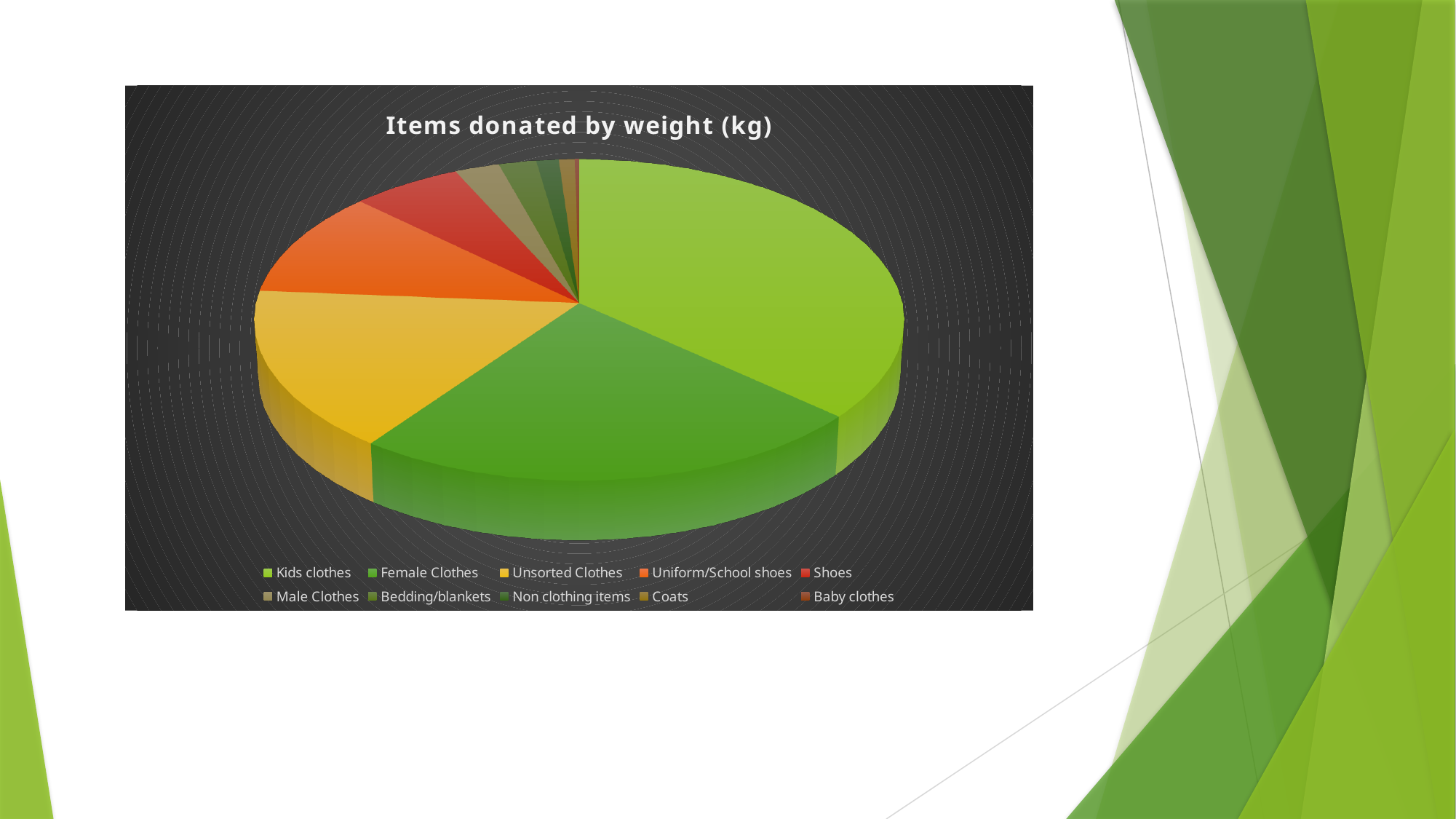
Which slice is larger, Female Clothes or Uniform/School shoes? Female Clothes Which slice is larger, Kids clothes or Unsorted Clothes? Kids clothes What kind of chart is shown on the slide? pie chart How many categories does the pie chart's legend list? 10 What colour is the Unsorted Clothes slice? yellow Which slice is larger, Uniform/School shoes or Baby clothes? Uniform/School shoes What is the title of the chart? Items donated by weight (kg) Which category has the smallest slice of the pie? Baby clothes